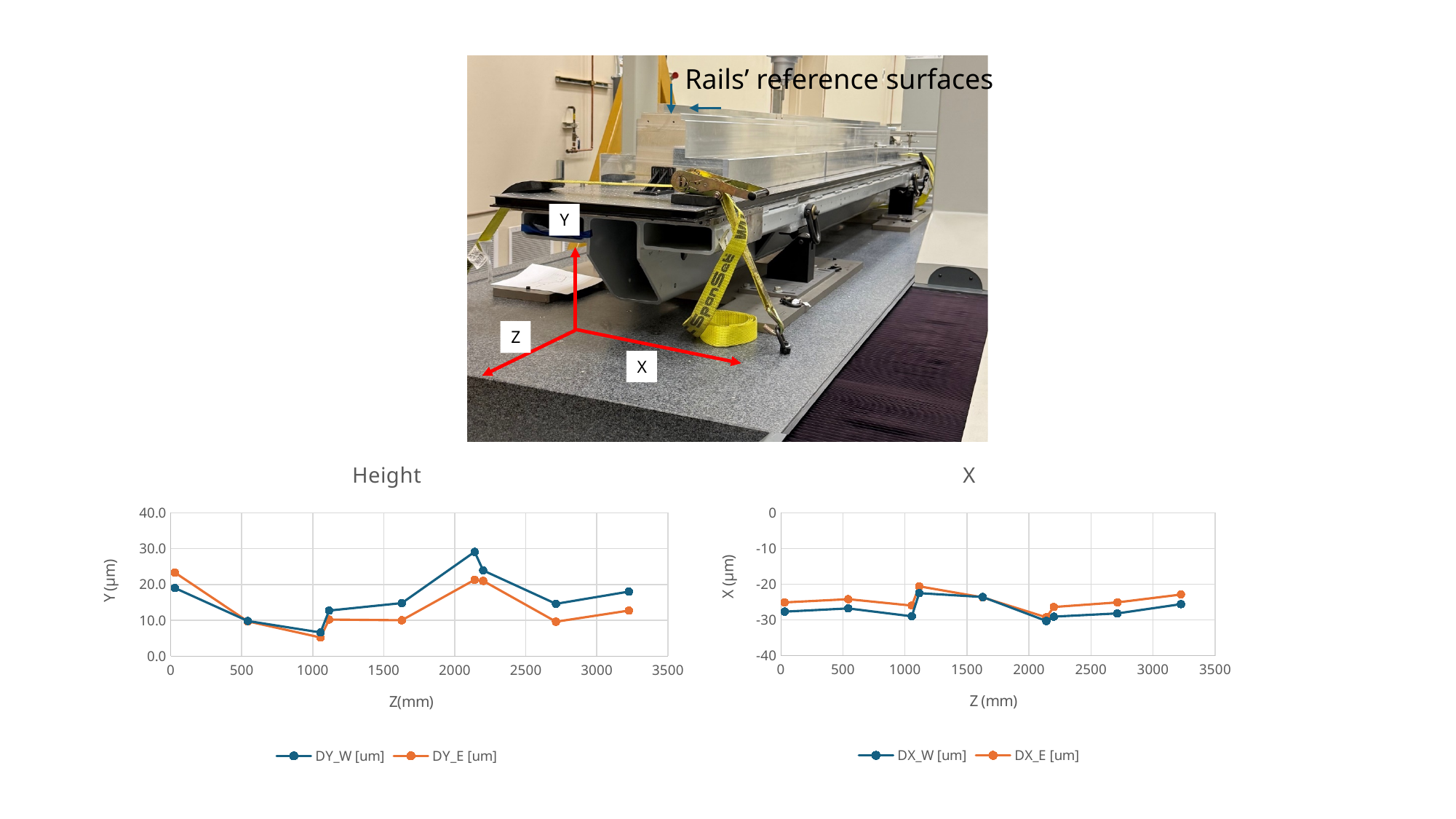
In the 'Height' chart, near Z = 2100 mm, which series has the larger value, DY_W [um] or DY_E [um]? DY_W [um] In the 'X' chart, does the DX_W [um] series rise or fall between Z = 2100 mm and Z = 3200 mm? rise In the 'Height' chart, how many data points does the DY_W [um] series have? 9 In the 'Height' chart, is the peak value of DY_W [um] near Z = 2100 mm greater or less than 20.0? greater In the 'X' chart, is the DX_W [um] value near Z = 2100 mm greater or less than -20? less In the 'Height' chart, is the DY_E [um] value near Z = 1000 mm greater or less than 10.0? less How many series does the legend of the 'X' chart list? 2 What kind of chart is the 'Height' chart? line chart What is the label of the vertical axis of the 'X' chart? X (µm) In the 'Height' chart, does the DY_W [um] series rise or fall between Z = 0 and Z = 1000 mm? fall